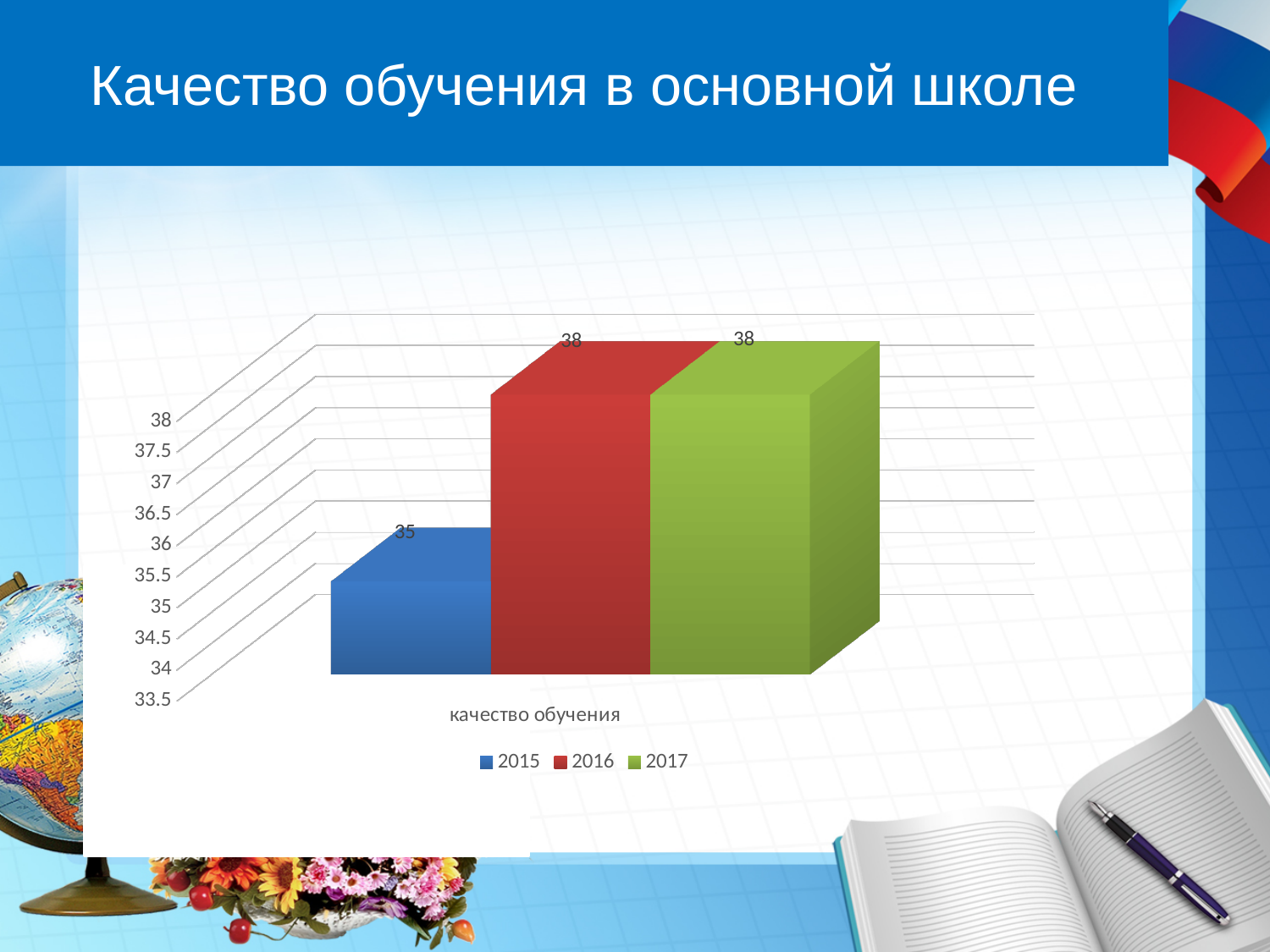
What is the difference between the values for 2016 and 2015? 3 Which year has the lowest value? 2015 Which is larger, the value for 2015 or the value for 2017? 2017 Do the values rise or fall from 2015 to 2016? rise What is the category label shown on the x axis? качество обучения What is the value for 2017? 38 What is the value for 2016? 38 What kind of chart is shown on the slide? bar chart Is the value for 2016 greater or less than 37? greater How many series does the legend list? 3 What is the value for 2015? 35 Is the value for 2015 greater or less than 36? less